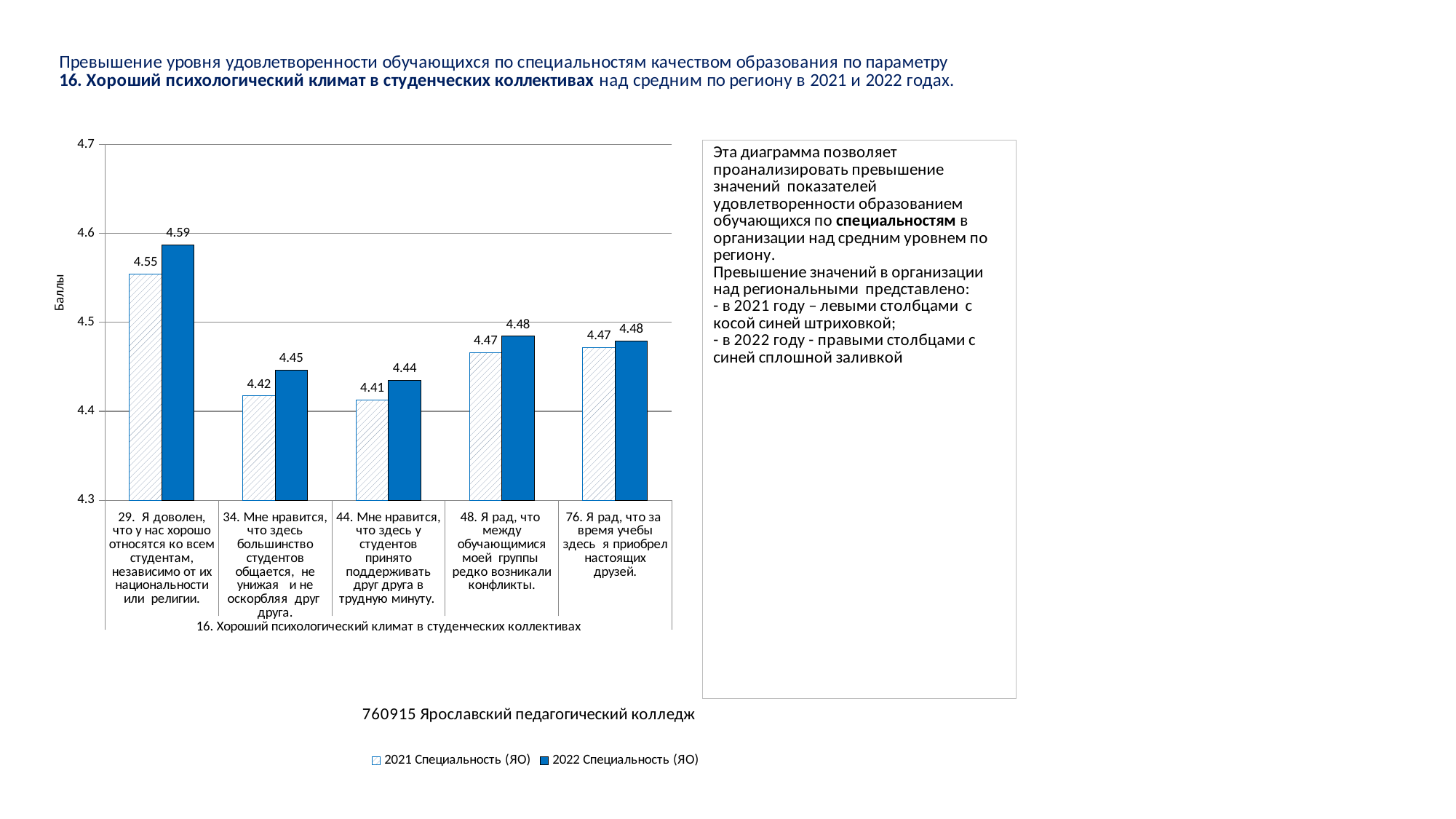
What is the 2022 Специальность (ЯО) value for category 29 (Я доволен, что у нас хорошо относятся ко всем студентам)? 4.59 Is the 2021 value for category 29 greater or less than 4.5? greater How many series does the legend list? 2 What is the 2021 Специальность (ЯО) value for category 34 (Мне нравится, что здесь большинство студентов общается, не унижая и не оскорбляя друг друга)? 4.42 Which is larger for category 48: the 2021 value or the 2022 value? 2022 Which category has the highest 2022 Специальность (ЯО) value? 29. Я доволен, что у нас хорошо относятся ко всем студентам, независимо от их национальности или религии. Which category has the lowest 2021 Специальность (ЯО) value? 44. Мне нравится, что здесь у студентов принято поддерживать друг друга в трудную минуту. What is the label of the y axis? Баллы How many categories are shown on the x axis of the chart? 5 What is the 2021 Специальность (ЯО) value for category 44 (Мне нравится, что здесь у студентов принято поддерживать друг друга)? 4.41 What is the difference between the 2022 and 2021 values for category 29? 0.04 What type of chart is shown on the slide? bar chart